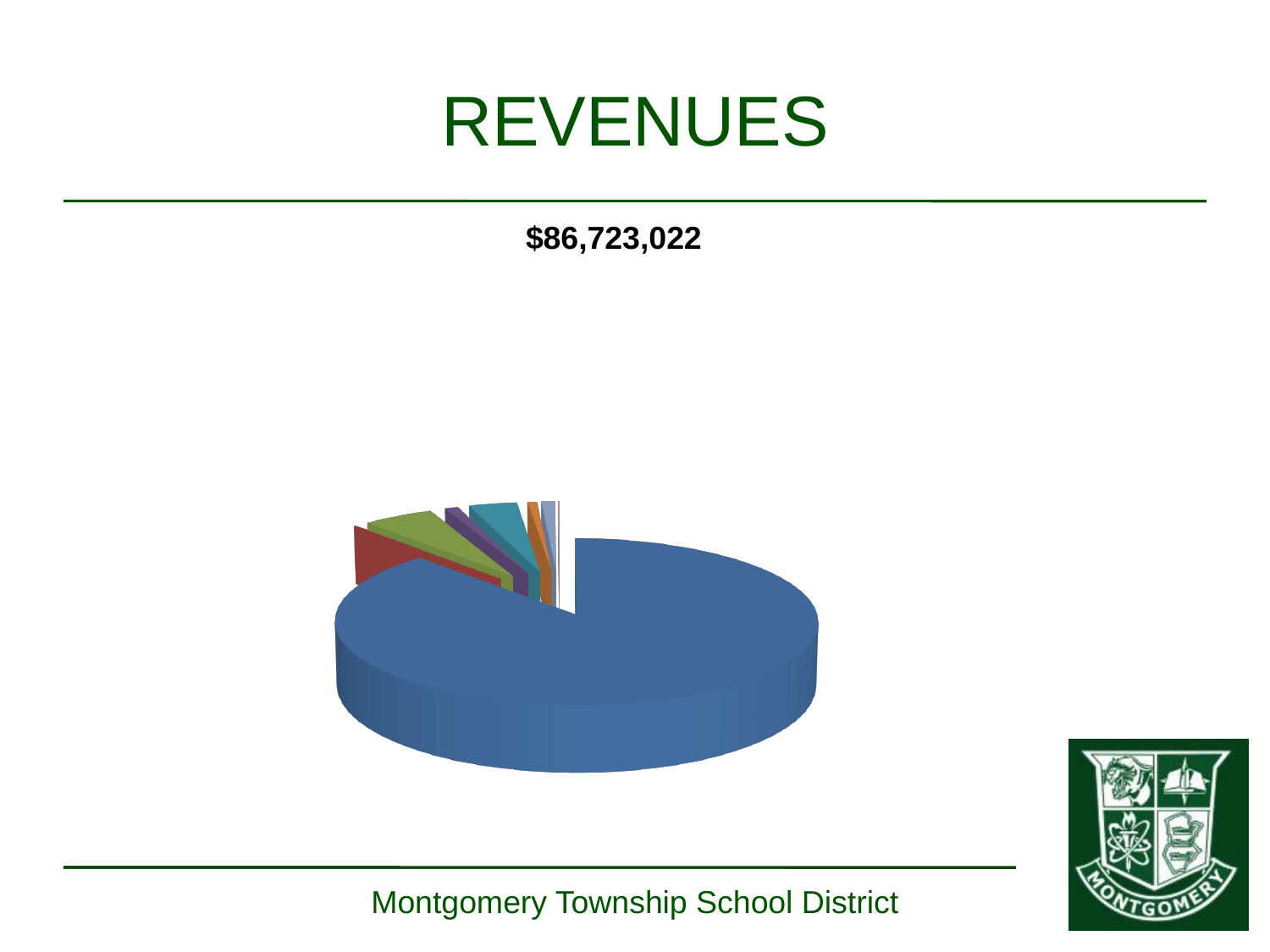
Does the blue slice account for more or less than half of the pie? more What is the title of the slide containing the pie chart? REVENUES Which is larger in the pie chart, the red slice or the orange slice? the red slice What total dollar amount is printed above the pie chart? $86,723,022 What kind of chart is shown on the slide? pie chart Which colour slice is the largest in the pie chart? blue Which is larger in the pie chart, the green slice or the light blue slice? the green slice